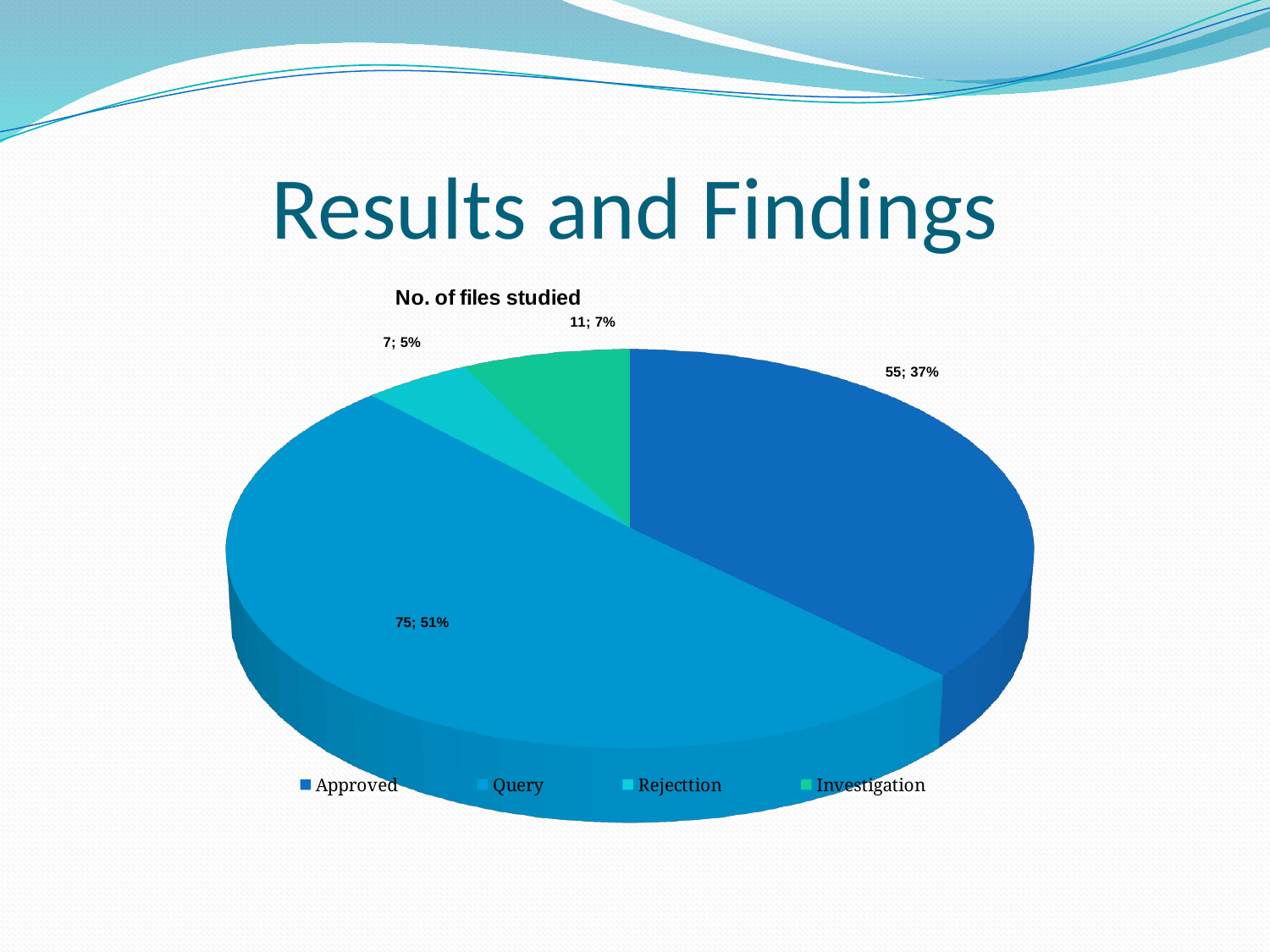
Which is larger, the number of Investigation files or Rejecttion files? Investigation What is the difference between the number of Query files and Approved files? 20 How many categories does the legend list? 4 Which category has the largest slice of the pie? Query What percentage share of the pie does Investigation have? 7% How many files were Approved according to the chart? 55 How many files fall under Rejecttion? 7 How many files fall under Query? 75 Which category has the smallest slice of the pie? Rejecttion What kind of chart is shown on the slide? Pie chart What percentage share of the pie does Query have? 51% What is the title of the chart? No. of files studied